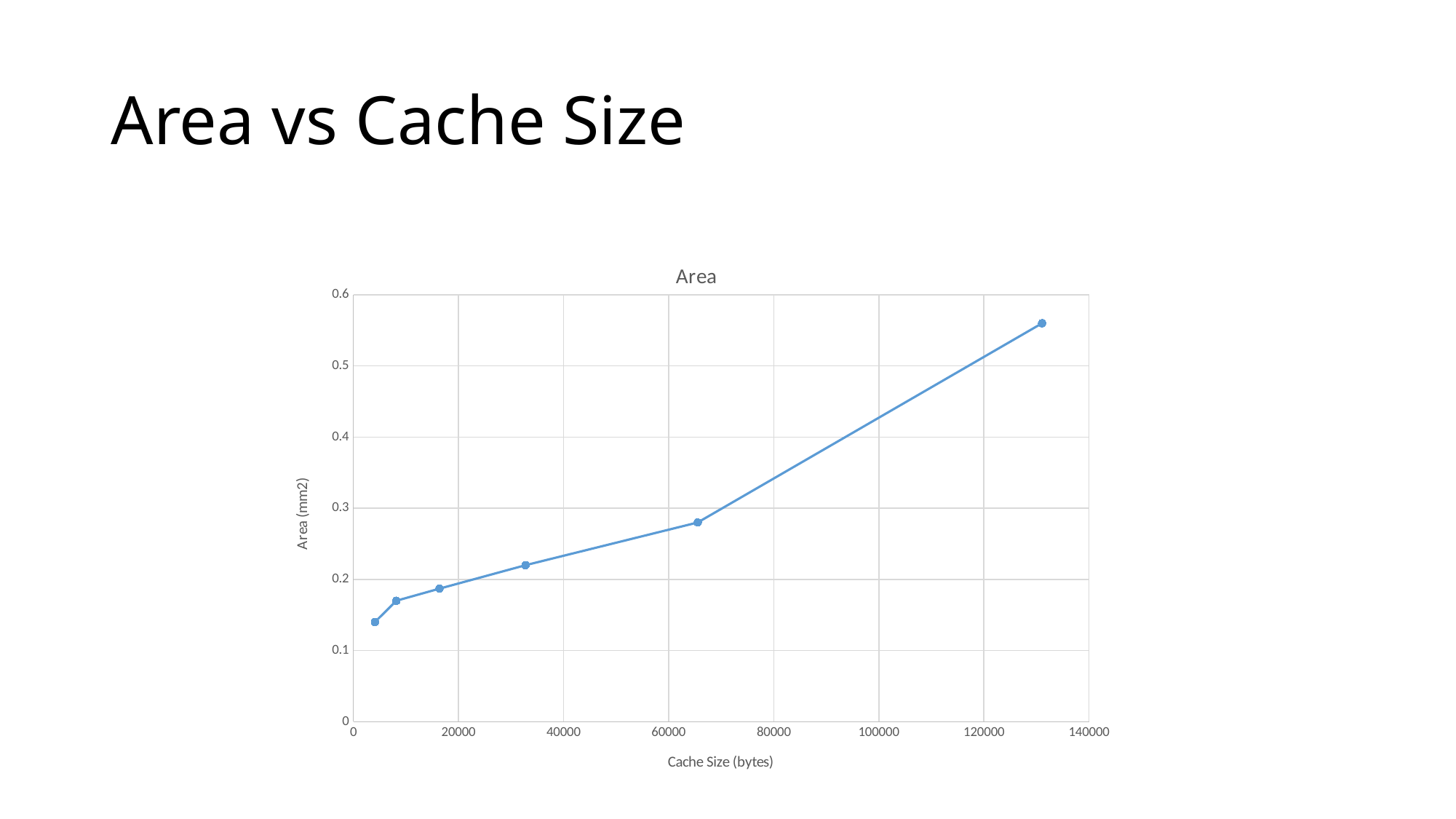
Which is larger: the area at roughly 65000 bytes or the area at roughly 33000 bytes? the area at roughly 65000 bytes Is the area value for the point at roughly 65000 bytes greater or less than 0.3? less Which plotted point has the highest area: the one at the smallest cache size or the one at the largest cache size? the one at the largest cache size Which plotted point has the lowest area value? the point at the smallest cache size How many data points are plotted on the chart? 6 Is the area value for the smallest cache size plotted greater or less than 0.2? less Is the area value for the largest cache size (around 130000 bytes) greater or less than 0.5? greater What is the title of the chart? Area What is the label of the x axis? Cache Size (bytes) What kind of chart is shown on the slide? line chart Does the area rise or fall as cache size increases along the x axis? rise